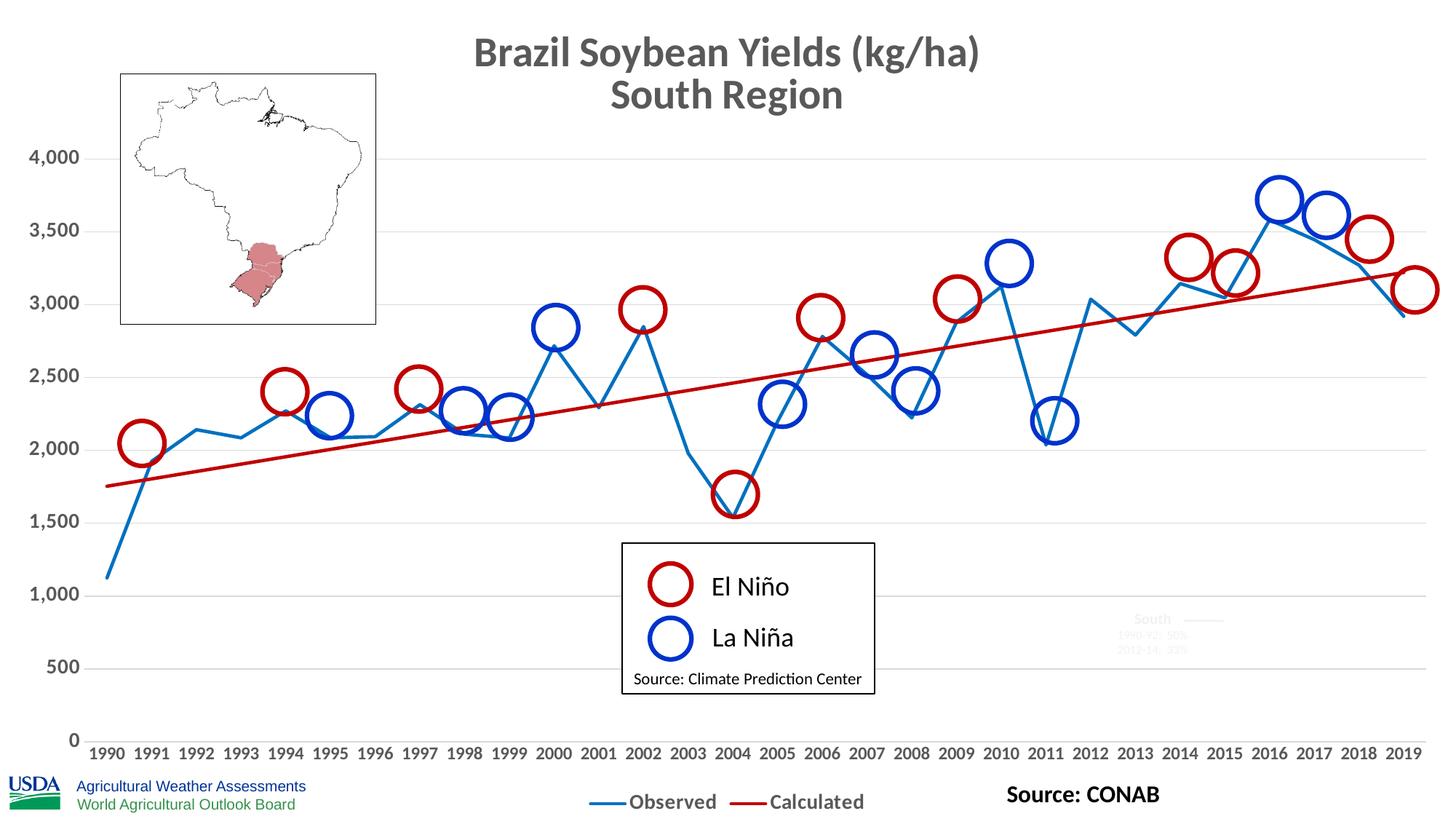
Is the Observed yield for 1990 greater or less than 1,500? less How many series does the legend at the bottom of the chart list? 2 Which year has the larger Observed yield, 2002 or 2003? 2002 What kind of chart is shown on the slide? line chart Do the Calculated (trend line) values rise or fall from 1990 to 2019? rise Is the Observed yield for 2000 greater or less than 2,500? greater In which year is the Observed soybean yield lowest? 1990 Which year has the larger Observed yield, 2010 or 2011? 2010 How many years are shown on the x axis of the chart? 30 What colour are the circles that mark El Niño years on the chart? red In which year is the Observed soybean yield highest? 2016 Is the Observed yield for 2016 greater or less than 3,500? greater